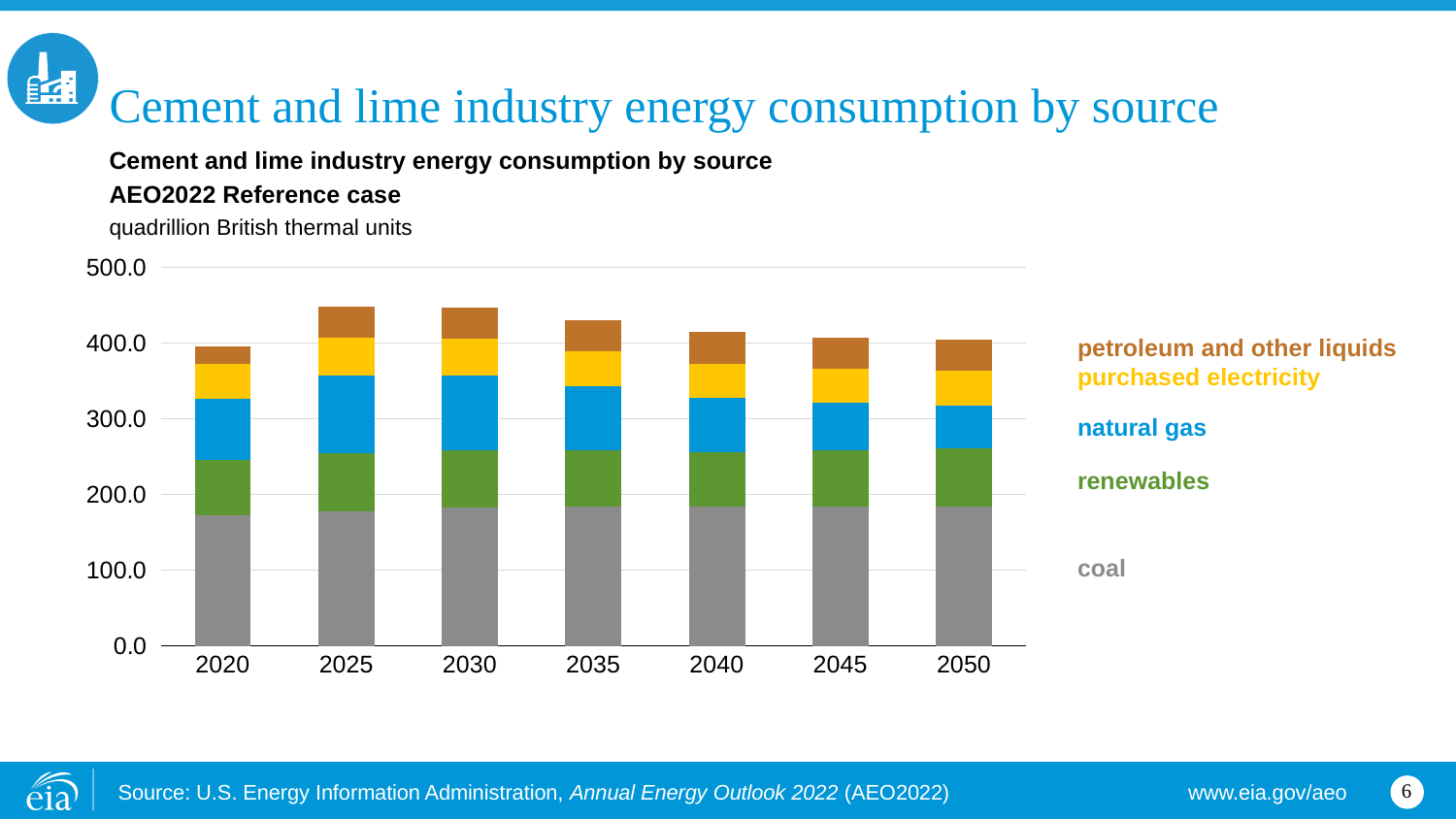
Which year has the lowest total energy consumption bar? 2020 Which energy source is shown at the bottom of each stacked bar? coal Is the total bar height for 2025 greater or less than 400? greater What unit is the chart's y axis measured in? quadrillion British thermal units How many years are shown along the x axis of the chart? 7 Is the coal value for 2020 greater or less than 200? less Is the total bar height for 2035 greater or less than 400? greater How many energy sources does the chart's legend list? 5 Which year has the larger total bar, 2020 or 2025? 2025 What kind of chart is shown on the slide? stacked bar chart From 2025 to 2050, do the total bar heights rise or fall? fall